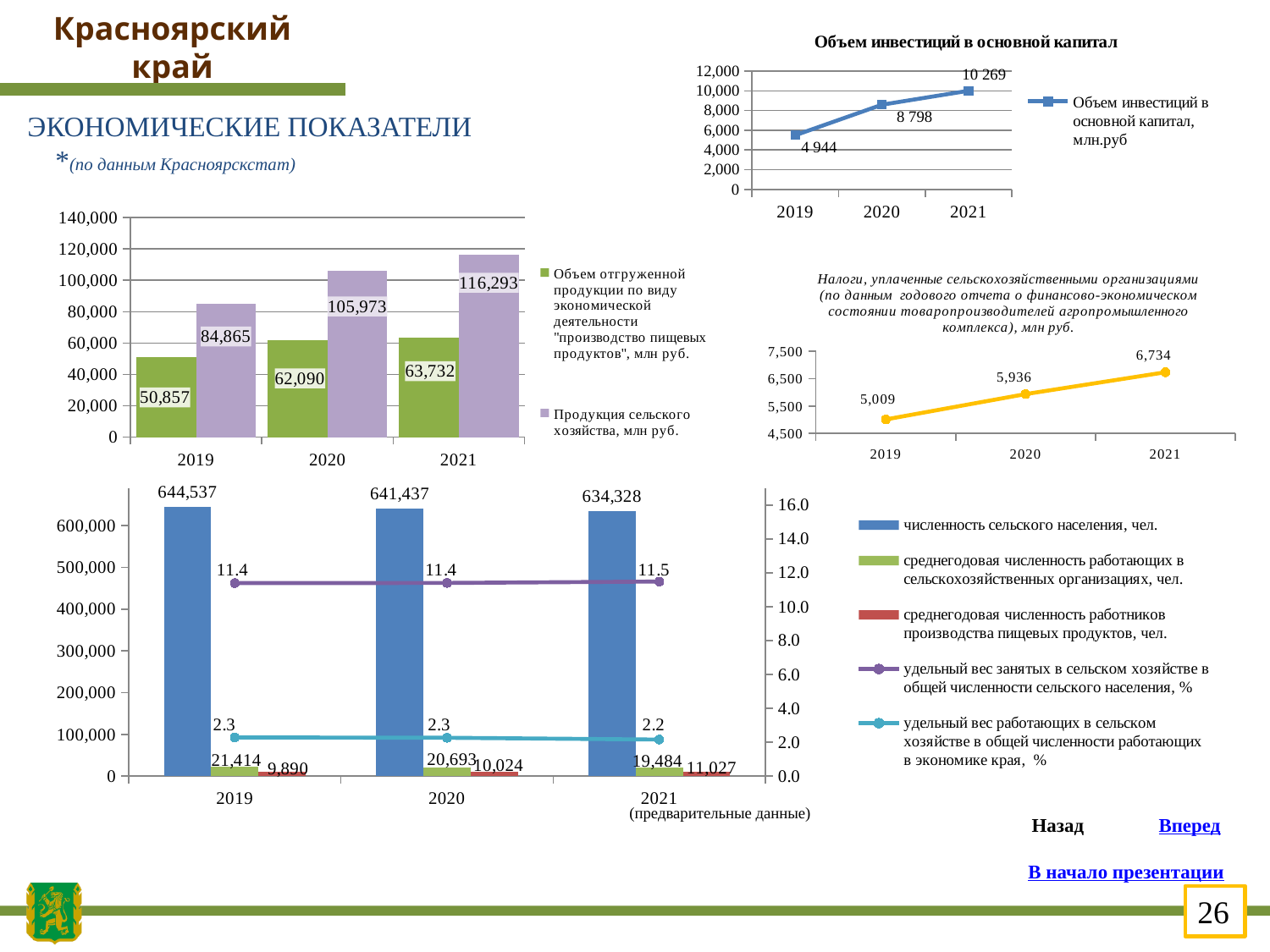
In the top-right chart 'Объем инвестиций в основной капитал', do the values rise or fall from 2019 to 2021? rise In the middle-right chart 'Налоги, уплаченные сельскохозяйственными организациями', what is the difference between the 2021 and 2019 values? 1,725 In the top-left bar chart, how many series does the legend list? 2 In the bottom-left chart, what is the value of 'среднегодовая численность работников производства пищевых продуктов, чел.' for 2020? 10,024 In the top-left bar chart, what is the difference between 'Продукция сельского хозяйства' and 'Объем отгруженной продукции' in 2019? 34,008 In the bottom-left chart, what is the value of 'численность сельского населения, чел.' for 2021? 634,328 In the top-right chart 'Объем инвестиций в основной капитал', what is the value for 2021? 10 269 In the top-left bar chart, what is the value of 'Продукция сельского хозяйства, млн руб.' for 2020? 105,973 In the bottom-left chart, which year has the lowest value for 'удельный вес работающих в сельском хозяйстве в общей численности работающих в экономике края, %'? 2021 In the top-right chart 'Объем инвестиций в основной капитал', what is the value for 2019? 4 944 In the middle-right chart 'Налоги, уплаченные сельскохозяйственными организациями', what is the value for 2020? 5,936 In the top-left bar chart, which year has the highest value for 'Объем отгруженной продукции ... производство пищевых продуктов'? 2021